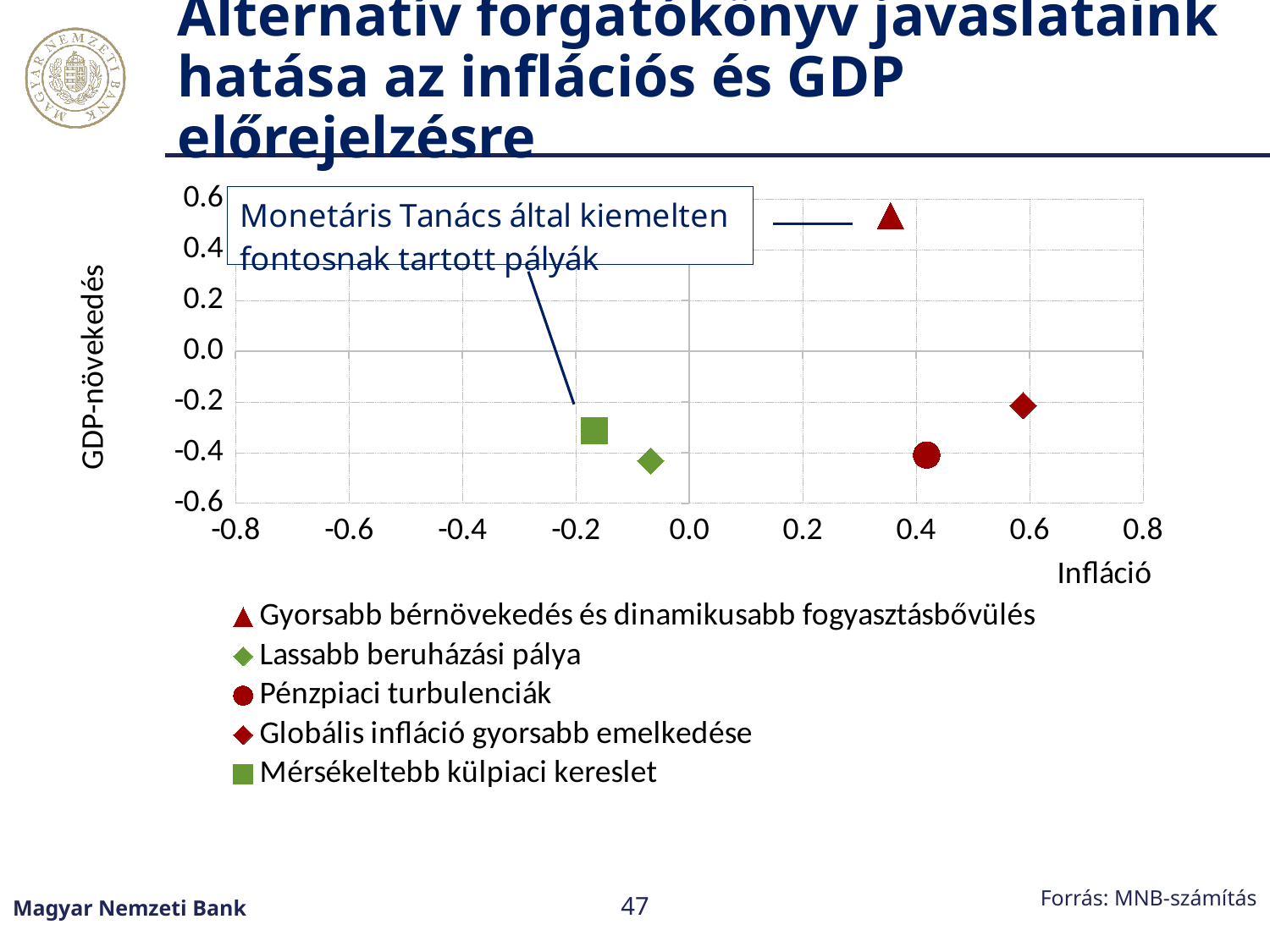
Which scenario has the highest GDP-növekedés value? Gyorsabb bérnövekedés és dinamikusabb fogyasztásbővülés What is the label of the horizontal axis of the chart? Infláció What kind of chart is shown on the slide? scatter chart Is the GDP-növekedés value for Pénzpiaci turbulenciák greater or less than -0.2? less Which scenario has the highest Infláció value? Globális infláció gyorsabb emelkedése Is the GDP-növekedés value for Gyorsabb bérnövekedés és dinamikusabb fogyasztásbővülés greater or less than 0.4? greater Which scenario has the lowest Infláció value? Mérsékeltebb külpiaci kereslet How many data points are plotted on the chart? 5 Which has the higher Infláció value: Pénzpiaci turbulenciák or Lassabb beruházási pálya? Pénzpiaci turbulenciák Is the Infláció value for Mérsékeltebb külpiaci kereslet greater or less than 0.0? less How many series does the legend list? 5